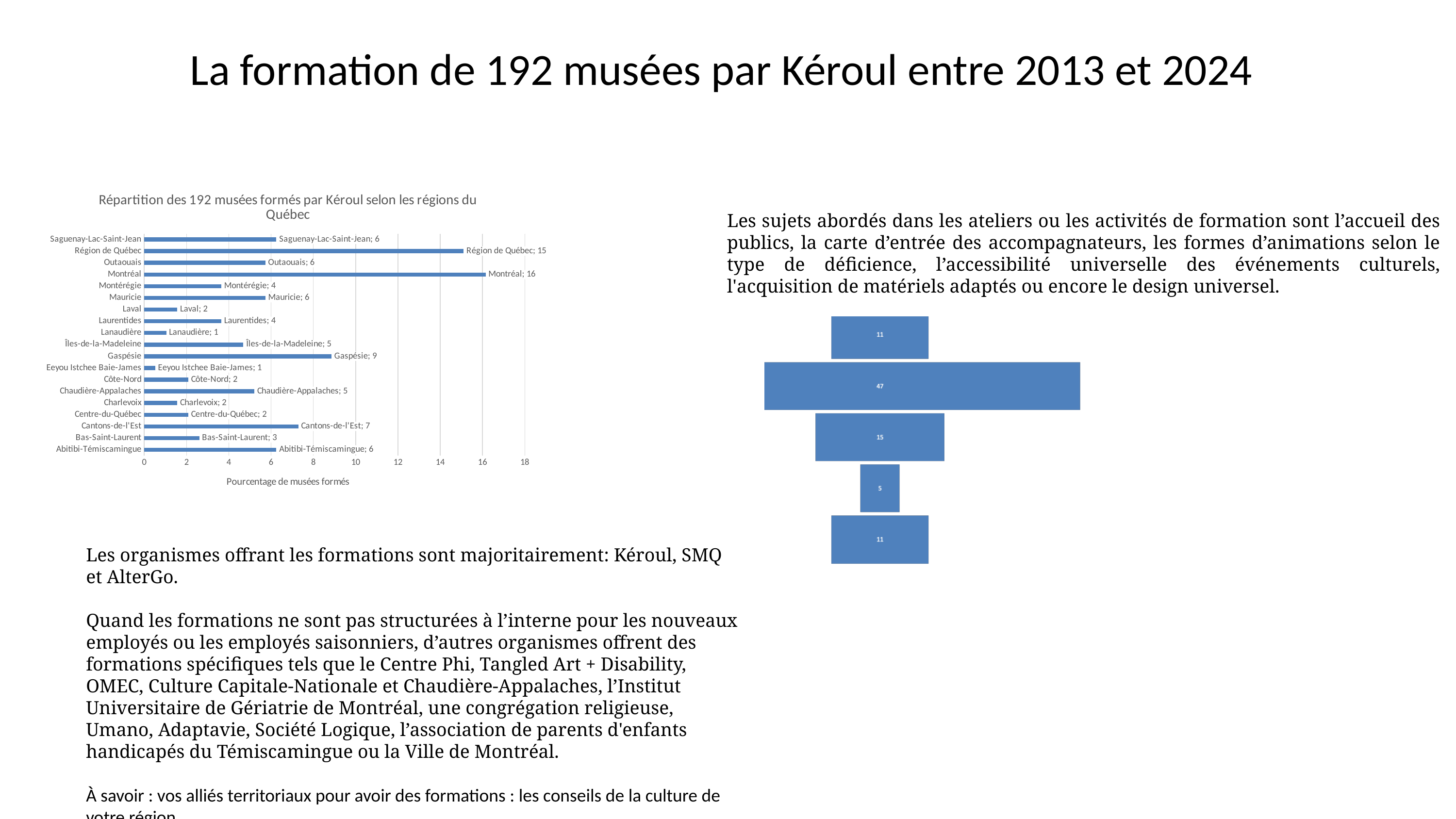
In the chart titled 'Répartition des 192 musées formés par Kéroul selon les régions du Québec', what is the value for Cantons-de-l'Est? 7 How many regions are shown in the chart titled 'Répartition des 192 musées formés par Kéroul selon les régions du Québec'? 19 In the chart titled 'Répartition des 192 musées formés par Kéroul selon les régions du Québec', what is the difference between the values for Gaspésie and Îles-de-la-Madeleine? 4 In the chart titled 'Répartition des 192 musées formés par Kéroul selon les régions du Québec', what is the value for Gaspésie? 9 What is the horizontal axis title of the chart titled 'Répartition des 192 musées formés par Kéroul selon les régions du Québec'? Pourcentage de musées formés What kind of chart is the chart titled 'Répartition des 192 musées formés par Kéroul selon les régions du Québec'? bar chart In the chart titled 'Répartition des 192 musées formés par Kéroul selon les régions du Québec', what is the value for Montréal? 16 In the chart titled 'Répartition des 192 musées formés par Kéroul selon les régions du Québec', what is the difference between the values for Montréal and Région de Québec? 1 In the chart titled 'Répartition des 192 musées formés par Kéroul selon les régions du Québec', which region has the highest value? Montréal In the chart titled 'Répartition des 192 musées formés par Kéroul selon les régions du Québec', what is the value for Bas-Saint-Laurent? 3 In the chart titled 'Répartition des 192 musées formés par Kéroul selon les régions du Québec', is the value for Région de Québec greater or less than 14? greater In the chart titled 'Répartition des 192 musées formés par Kéroul selon les régions du Québec', which is larger, the value for Gaspésie or the value for Cantons-de-l'Est? Gaspésie